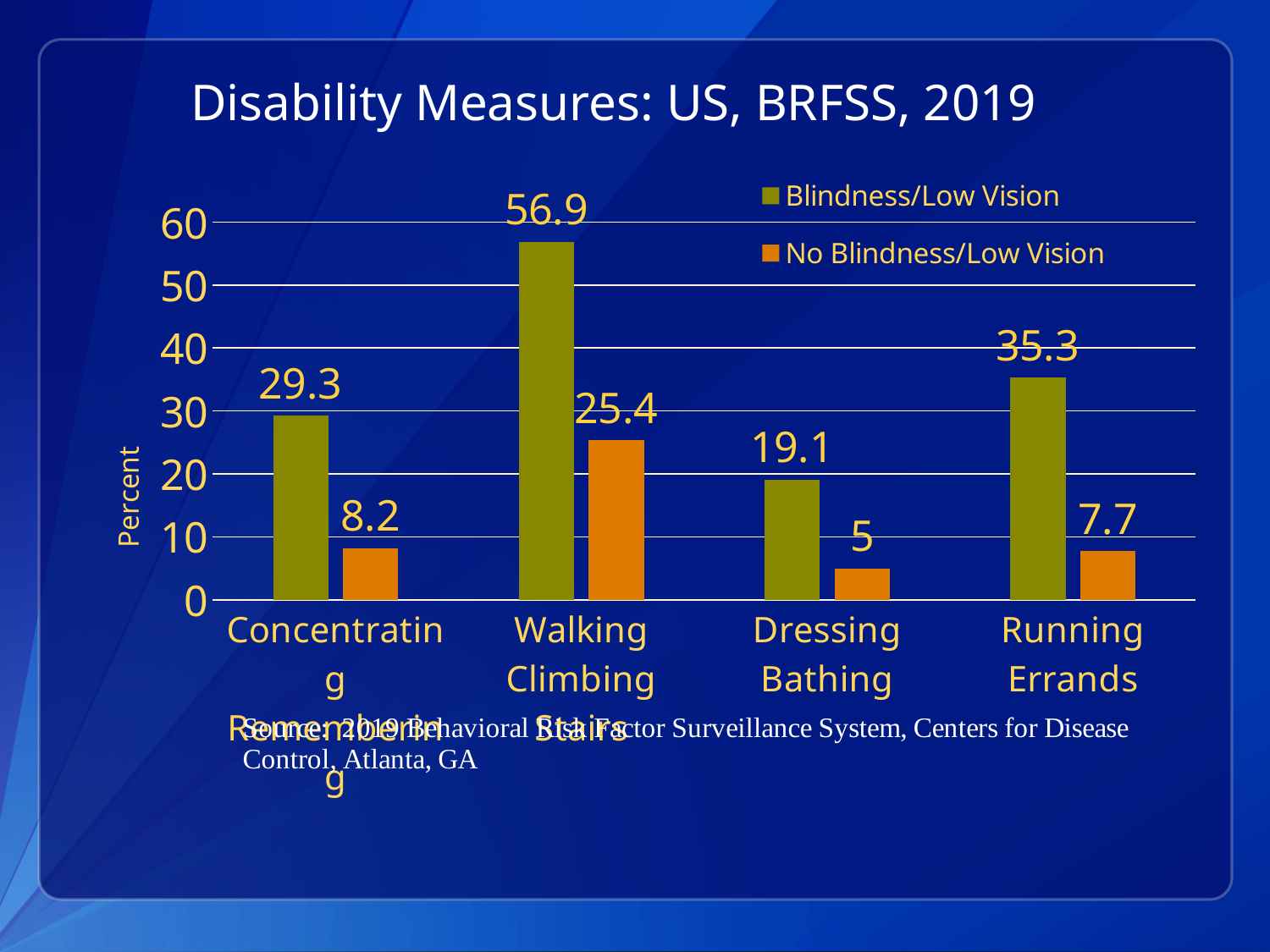
What is the value for Blindness/Low Vision in the Walking Climbing Stairs category? 56.9 What is the difference between the Blindness/Low Vision and No Blindness/Low Vision values for Walking Climbing Stairs? 31.5 Which category has the highest Blindness/Low Vision value? Walking Climbing Stairs What is the title of the chart? Disability Measures: US, BRFSS, 2019 How many series does the legend list? 2 How many categories are shown on the x axis? 4 What is the value for Blindness/Low Vision in the Running Errands category? 35.3 Which category has the lowest No Blindness/Low Vision value? Dressing Bathing What kind of chart is shown on the slide? Bar chart What is the value for No Blindness/Low Vision in the Dressing Bathing category? 5 Which is larger: the Blindness/Low Vision value for Concentrating Remembering or for Running Errands? Running Errands What is the value for No Blindness/Low Vision in the Concentrating Remembering category? 8.2